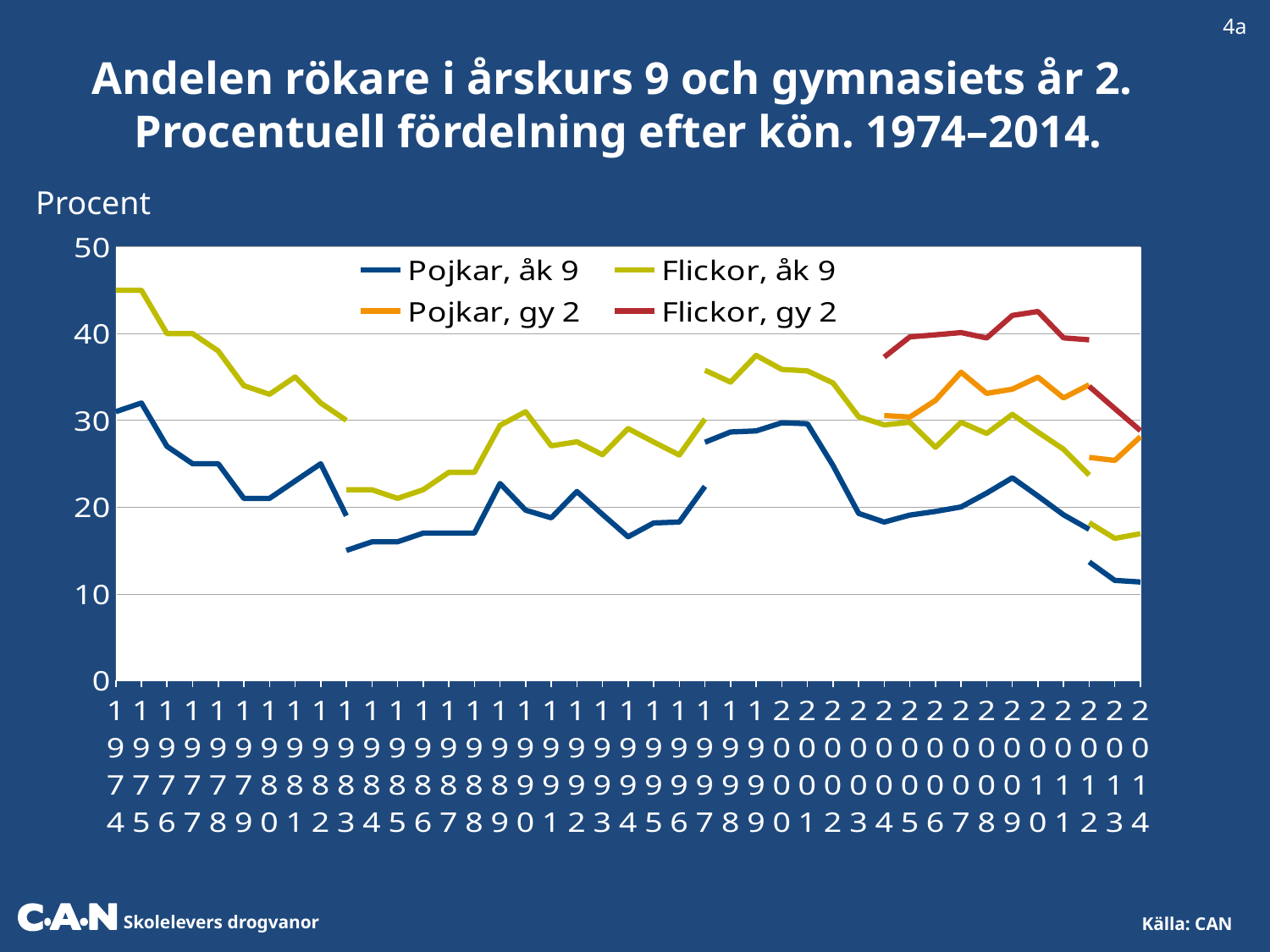
What kind of chart is shown on the slide? line chart Is the value for Pojkar, åk 9 in 2014 greater or less than 20? less Does the value for Pojkar, åk 9 rise or fall from 1974 to 1983? fall Is the value for Flickor, åk 9 in 2014 greater or less than 20? less In 1974, which is larger: the value for Flickor, åk 9 or the value for Pojkar, åk 9? Flickor, åk 9 In 2014, which is larger: the value for Flickor, gy 2 or the value for Pojkar, åk 9? Flickor, gy 2 How many series does the legend list? 4 Which series are listed in the legend? Pojkar, åk 9; Flickor, åk 9; Pojkar, gy 2; Flickor, gy 2 What label is shown on the vertical axis of the chart? Procent Is the value for Flickor, åk 9 in 1974 greater or less than 40? greater Which series has the highest value in 2010? Flickor, gy 2